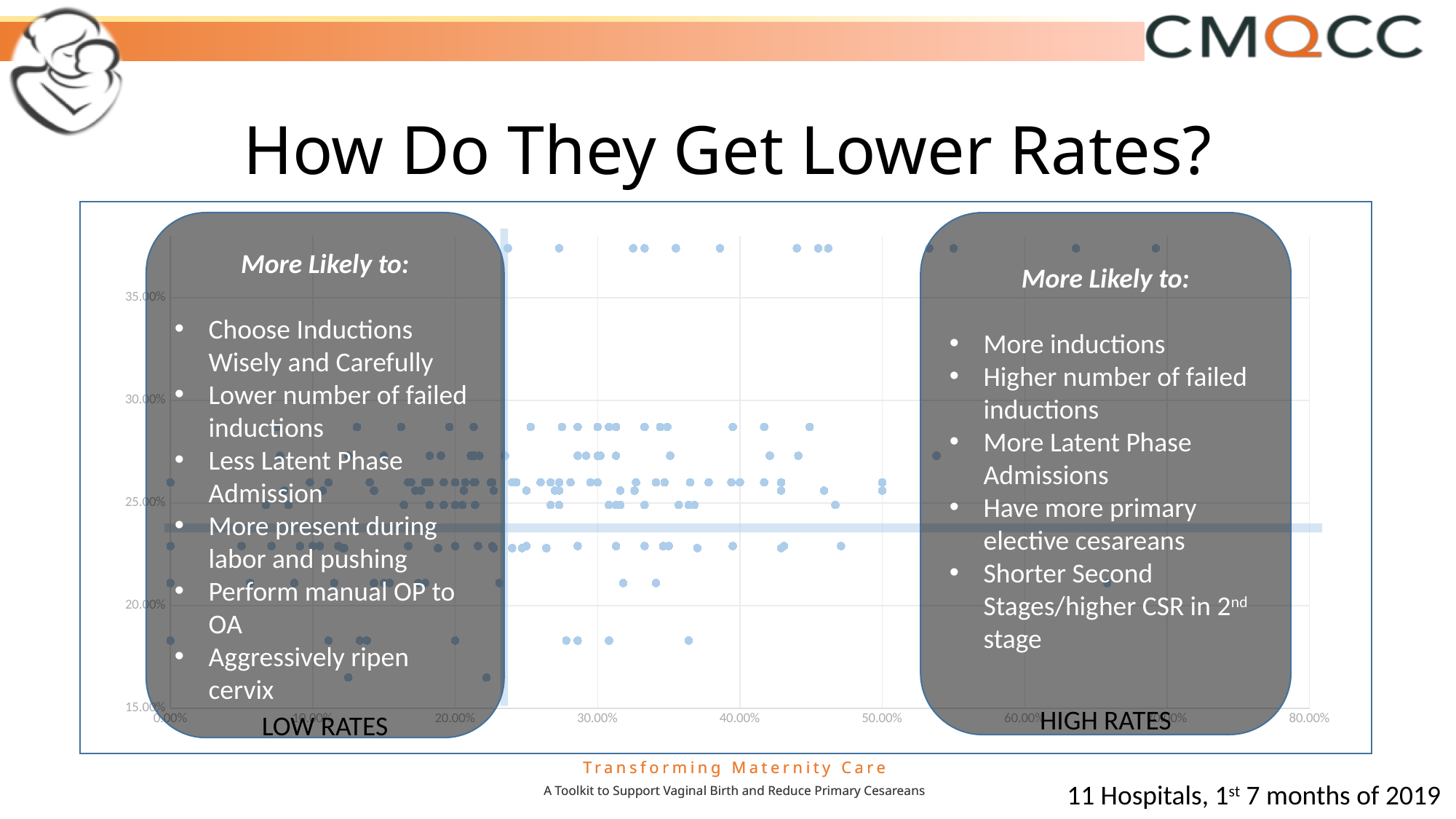
Is the horizontal reference line on the chart greater or less than 20.00% on the y axis? greater What is the rightmost x-axis tick label shown on the chart? 80.00% What kind of chart is shown on the slide? scatter chart Is the horizontal reference line on the chart greater or less than 25.00% on the y axis? less What is the highest y-axis tick label shown on the chart? 35.00%